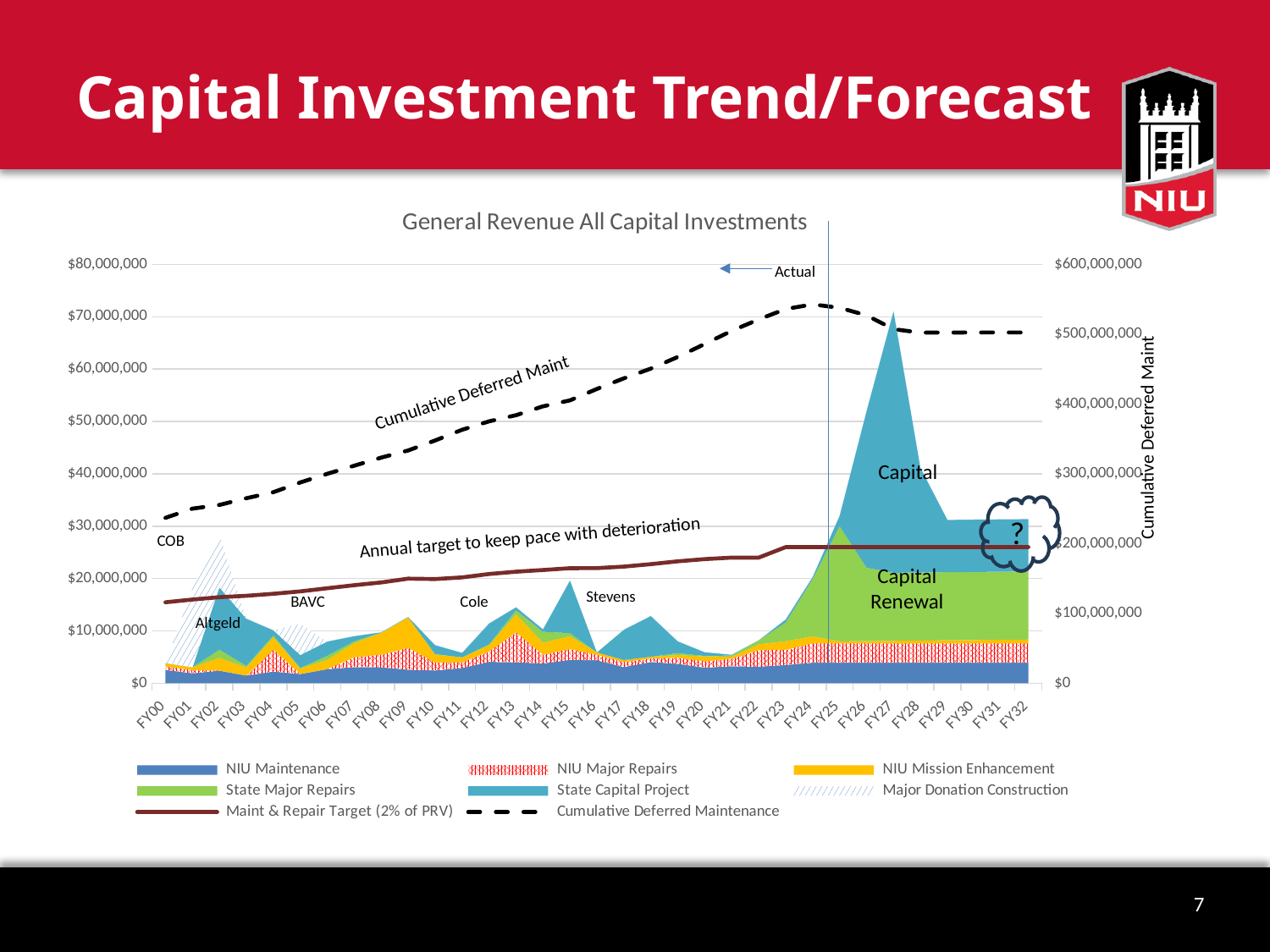
In which fiscal year does the stacked capital investment total reach its highest point? FY27 Does the Cumulative Deferred Maintenance line rise or fall from FY00 to FY24? rise Which fiscal year has the larger stacked capital investment total, FY27 or FY10? FY27 How many series does the chart legend list? 8 Is the stacked capital investment total in FY20 greater or less than $10,000,000? less What is the title of the chart? General Revenue All Capital Investments Is the peak of the Cumulative Deferred Maintenance line greater or less than $500,000,000 on the right axis? greater How many fiscal years are shown along the x axis of the chart? 33 Is the stacked capital investment total in FY27 greater or less than $60,000,000? greater What is the label of the right-hand vertical axis? Cumulative Deferred Maint What kind of chart is shown on the slide? Combination area and line chart